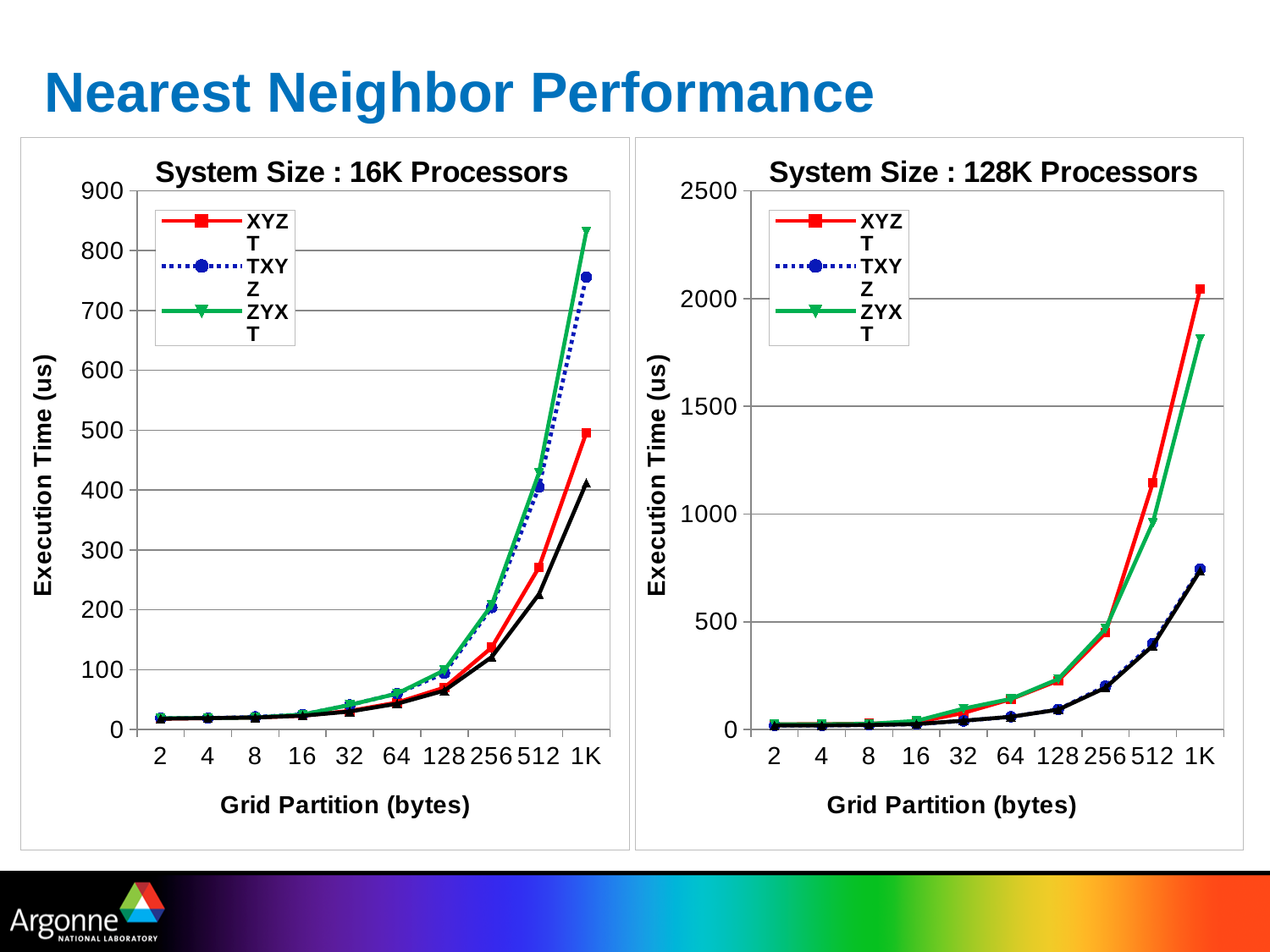
How many grid partition sizes are shown on the x axis of the 'System Size : 16K Processors' chart? 10 In the 'System Size : 128K Processors' chart, which legend series has the highest execution time at a grid partition of 1K? XYZT What type of chart is the 'System Size : 16K Processors' chart? line chart What is the y-axis label of the 'System Size : 128K Processors' chart? Execution Time (us) In the 'System Size : 128K Processors' chart, which is larger at 1K: the execution time for XYZT or for TXYZ? XYZT In the 'System Size : 128K Processors' chart, is the execution time for TXYZ at 1K greater or less than 1000? less In the 'System Size : 16K Processors' chart, which legend series has the highest execution time at a grid partition of 1K? ZYXT In the 'System Size : 16K Processors' chart, does execution time rise or fall as grid partition size increases? rise In the 'System Size : 16K Processors' chart, is the execution time for ZYXT at 1K greater or less than 800? greater In the 'System Size : 16K Processors' chart, is the execution time for XYZT at 1K greater or less than 400? greater How many series does the legend list in the 'System Size : 128K Processors' chart? 3